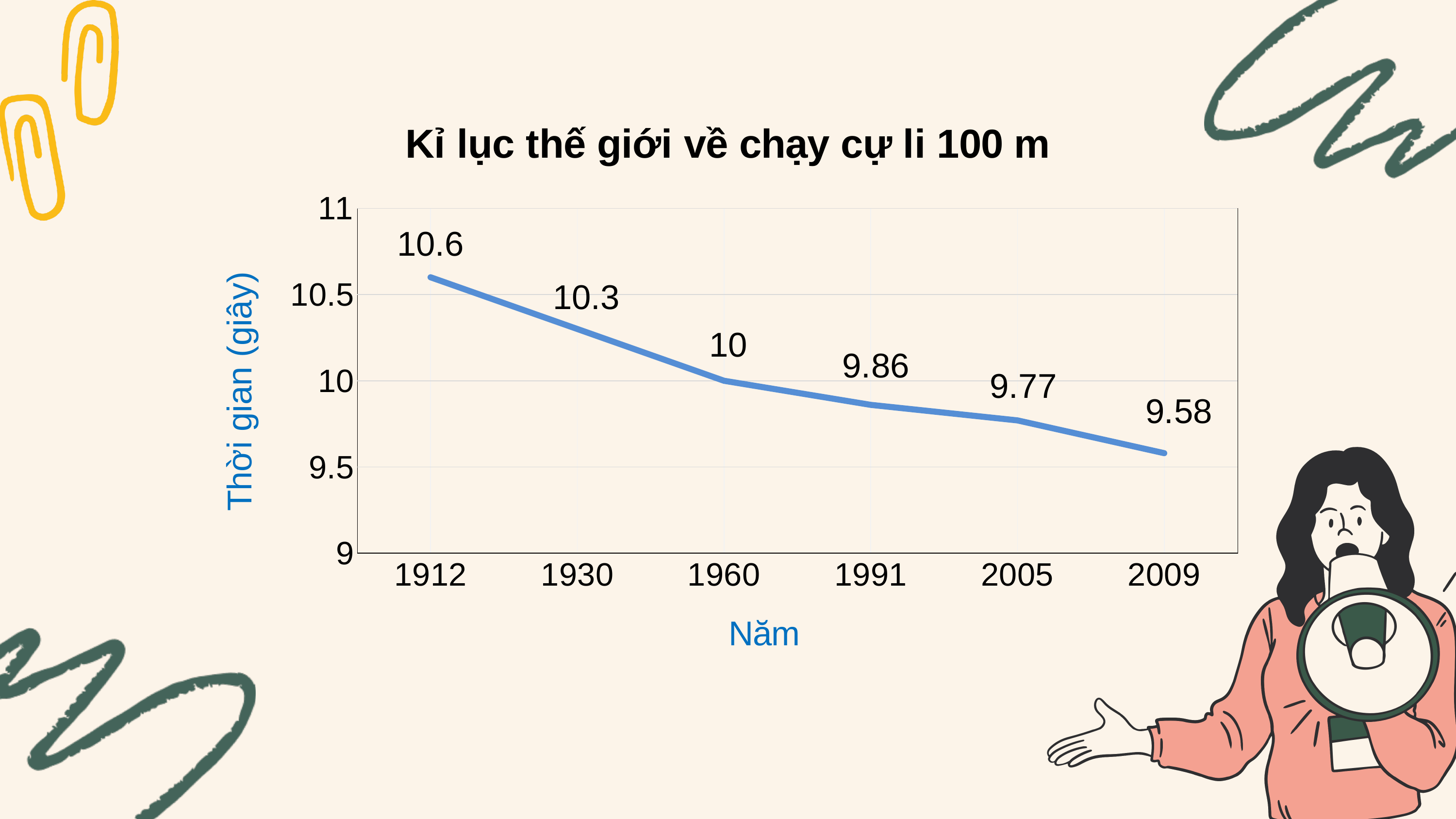
What kind of chart is shown on the slide? line chart How many years are plotted on the chart? 6 Which year has the highest record time on the chart? 1912 What is the world record time shown for 1912? 10.6 What is the world record time shown for 2009? 9.58 What is the difference between the record times for 2005 and 2009? 0.19 What is the difference between the record times for 1912 and 2009? 1.02 What is the title of the chart? Kỉ lục thế giới về chạy cự li 100 m What is the world record time shown for 1991? 9.86 Do the record times rise or fall from 1912 to 2009? fall Which is larger, the record time for 1930 or for 1960? 1930 Which year has the lowest record time on the chart? 2009